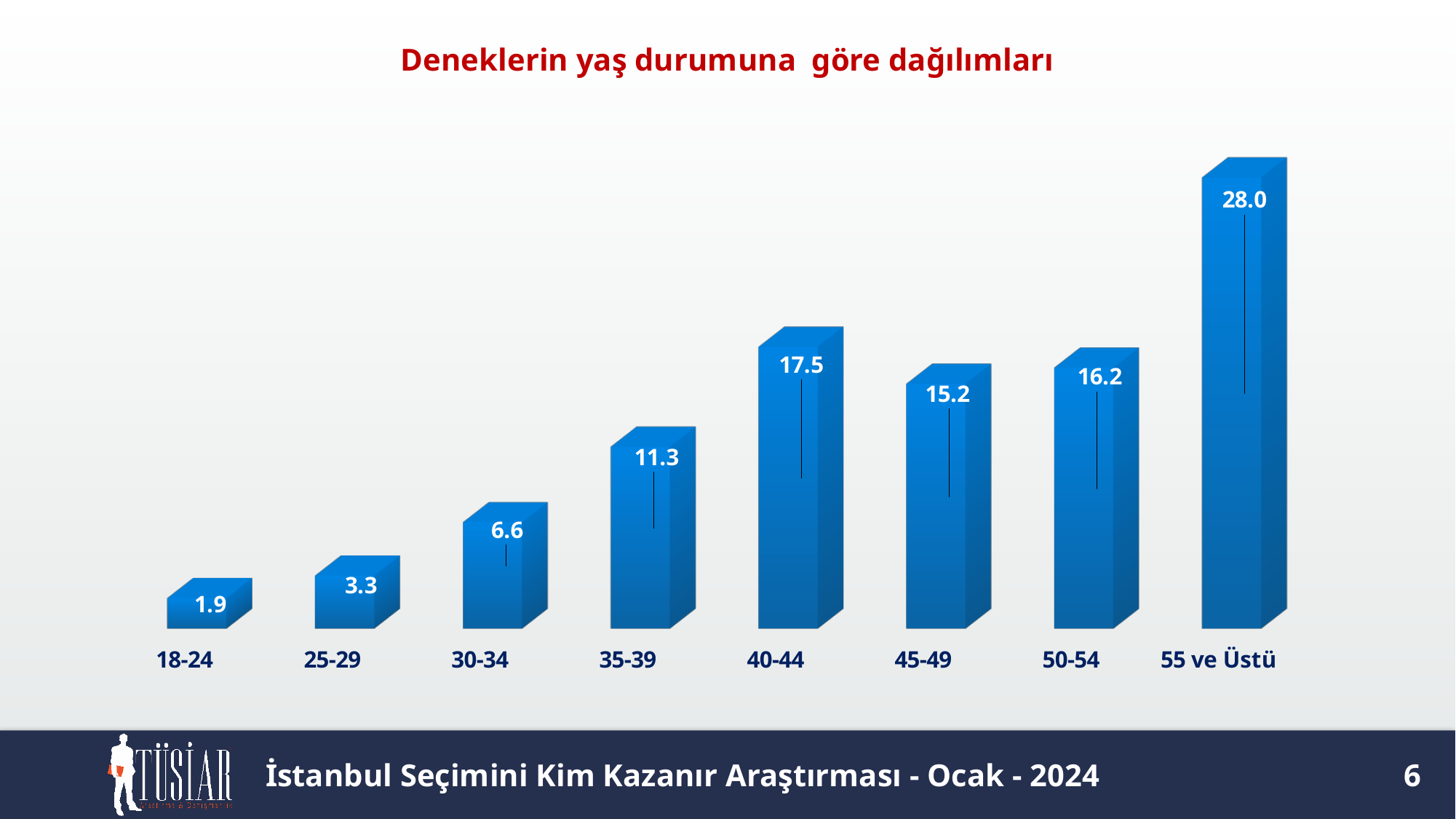
What is the difference between the values for 30-34 and 25-29? 3.3 What is the difference between the values for 55 ve Üstü and 40-44? 10.5 What kind of chart is shown on the slide? bar chart What is the value for the 18-24 age group? 1.9 Which age group has the lowest value? 18-24 What colour are the bars in the chart? blue Which is larger, the value for 45-49 or the value for 50-54? 50-54 What is the value for the 55 ve Üstü age group? 28.0 How many age groups are shown in the chart? 8 What is the value for the 40-44 age group? 17.5 Which age group has the highest value? 55 ve Üstü What is the title of the chart? Deneklerin yaş durumuna göre dağılımları